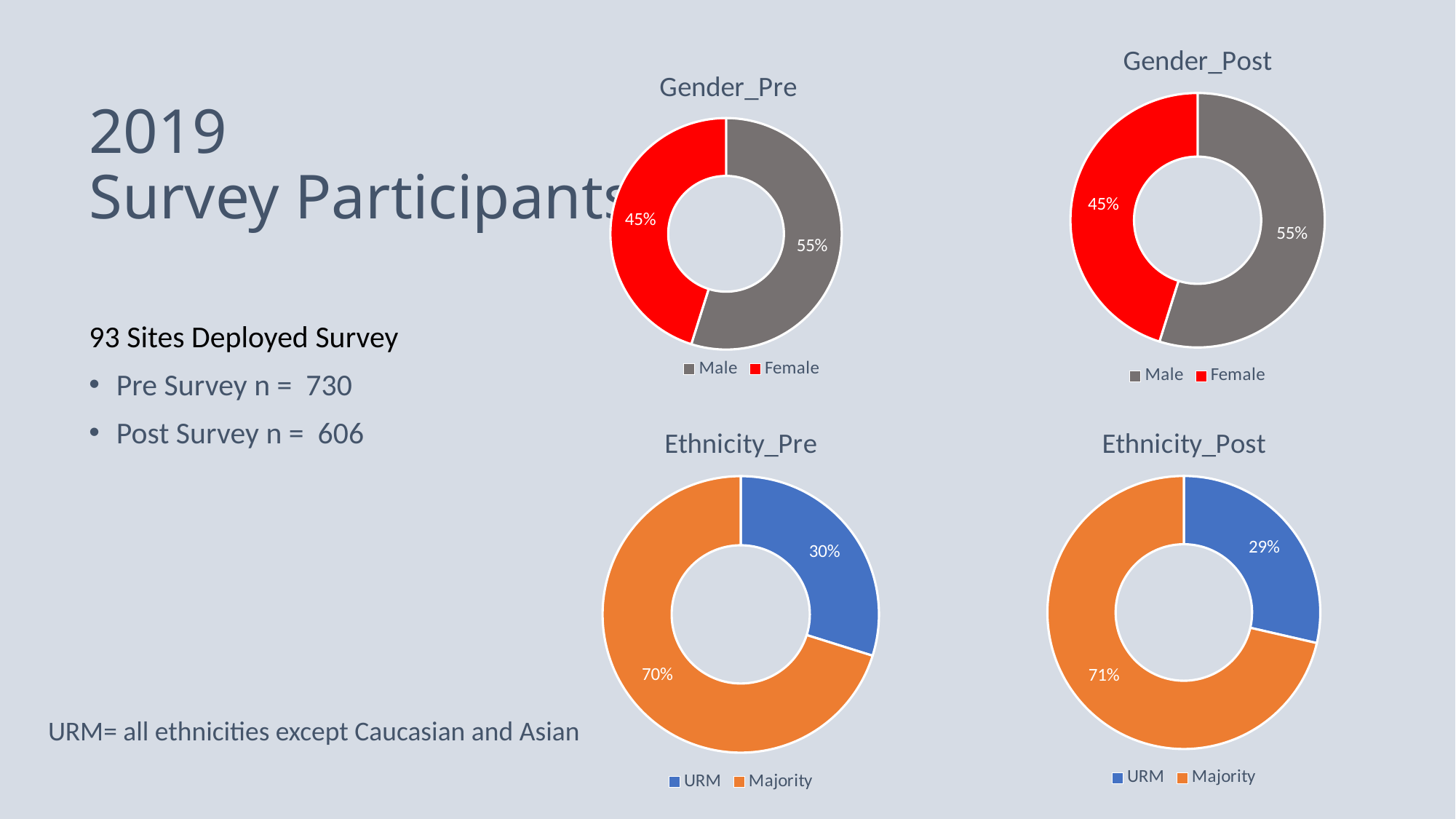
In the Gender_Pre chart, which is larger, Male or Female? Male In the Ethnicity_Pre chart, what percentage is URM? 30% In the Ethnicity_Post chart, what percentage is Majority? 71% In the Gender_Pre chart, what percentage is Male? 55% In the Ethnicity_Post chart, what percentage is URM? 29% In the Gender_Pre chart, what percentage is Female? 45% In the Ethnicity_Pre chart, which category has the largest share? Majority What type of chart is the Ethnicity_Post chart? Doughnut chart How many categories does the legend of the Gender_Post chart list? 2 In the Ethnicity_Pre chart, what is the difference between the Majority and URM shares? 40% In the Gender_Post chart, which category has the smaller share? Female In the Gender_Post chart, what percentage is Female? 45%